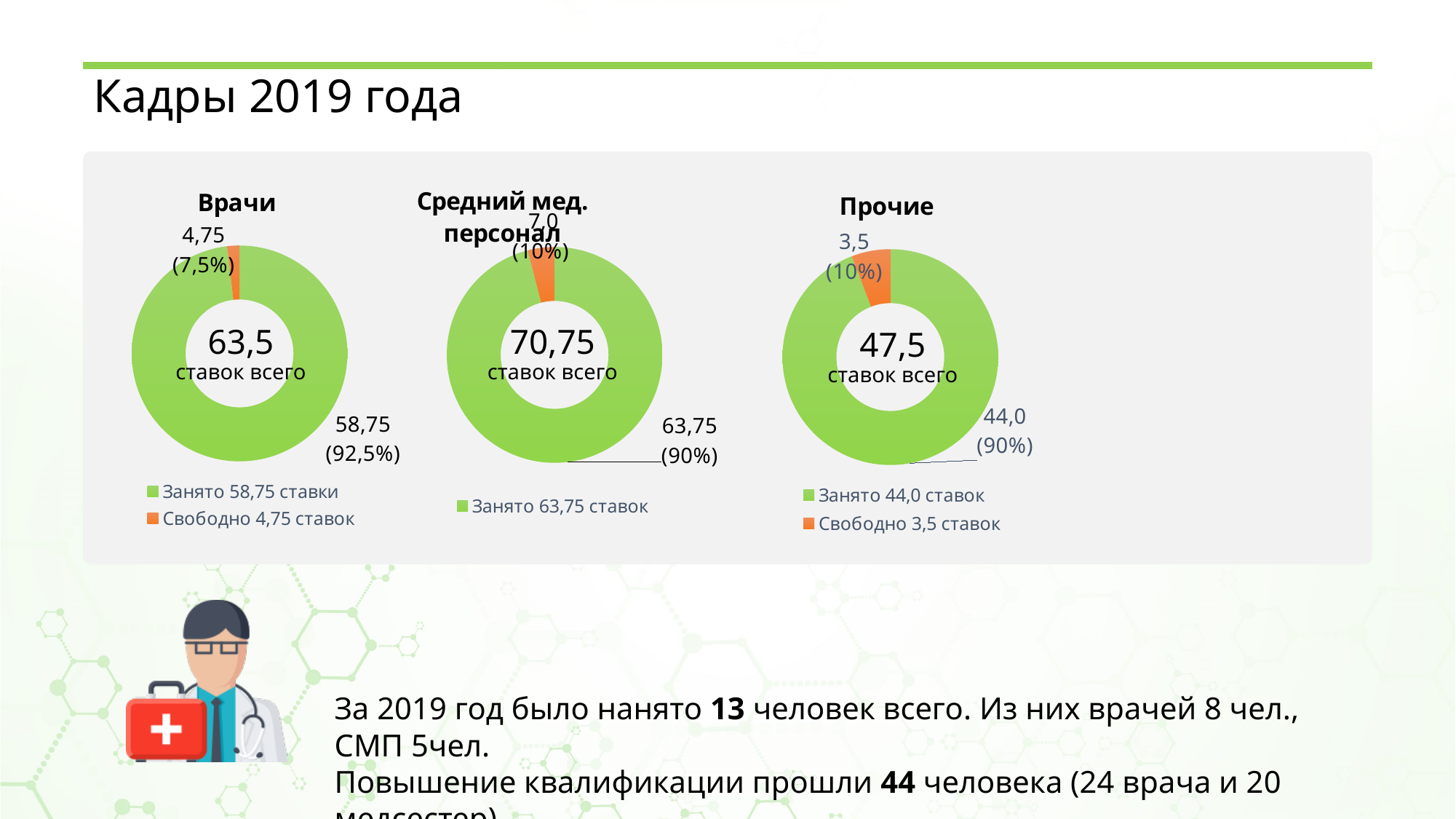
In the "Прочие" chart, what share of the total is occupied (Занято)? 90% Which of the three charts has the largest total number of ставок? Средний мед. персонал In the "Врачи" chart, which slice is larger: Занято or Свободно? Занято In the "Средний мед. персонал" chart, what is the value of the free (orange) slice? 7,0 In the "Прочие" chart, what is the difference between the occupied and free values? 40,5 What is the total number of ставок shown in the centre of the "Средний мед. персонал" chart? 70,75 In the "Врачи" chart, what share of the total do the free (Свободно) positions make up? 7,5% Which of the three charts has the smallest total number of ставок? Прочие In the "Врачи" chart, how many ставок are occupied (Занято)? 58,75 What kind of chart is used for the "Врачи" chart? Donut (pie) chart How many slices does the "Прочие" chart have? 2 How many entries does the legend of the "Средний мед. персонал" chart list? 1